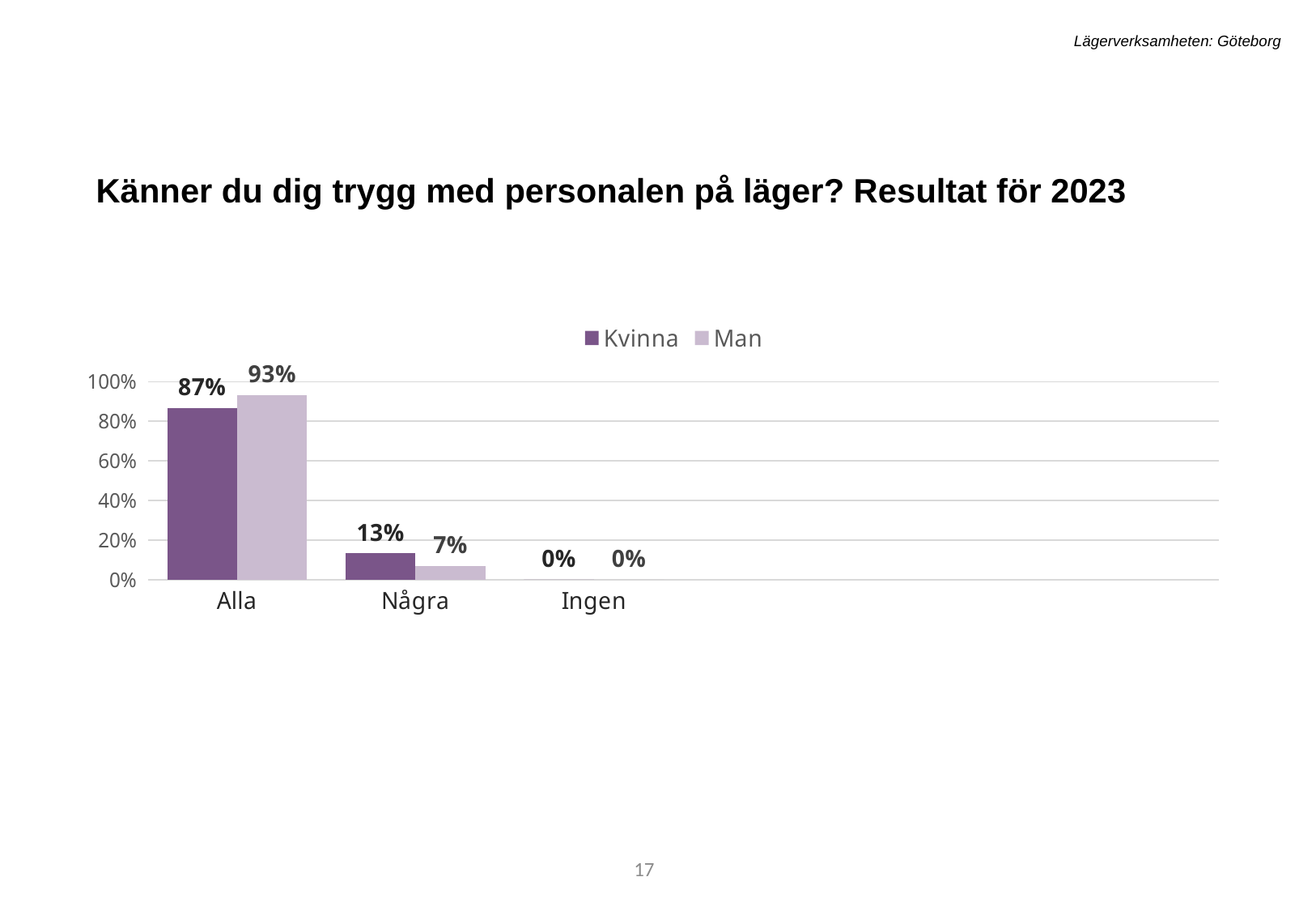
What is the value for Kvinna in the Alla category? 87% How many series does the legend list? 2 What is the difference between the Man and Kvinna values in the Alla category? 6% What is the value for Man in the Några category? 7% What kind of chart is shown on the slide? Bar chart What is the value for Kvinna in the Ingen category? 0% How many categories are shown on the x axis? 3 What is the value for Man in the Alla category? 93% Which category has the lowest value for the Kvinna series? Ingen What is the value for Kvinna in the Några category? 13% Which category has the highest value for the Man series? Alla In the Några category, which series has the larger value, Kvinna or Man? Kvinna